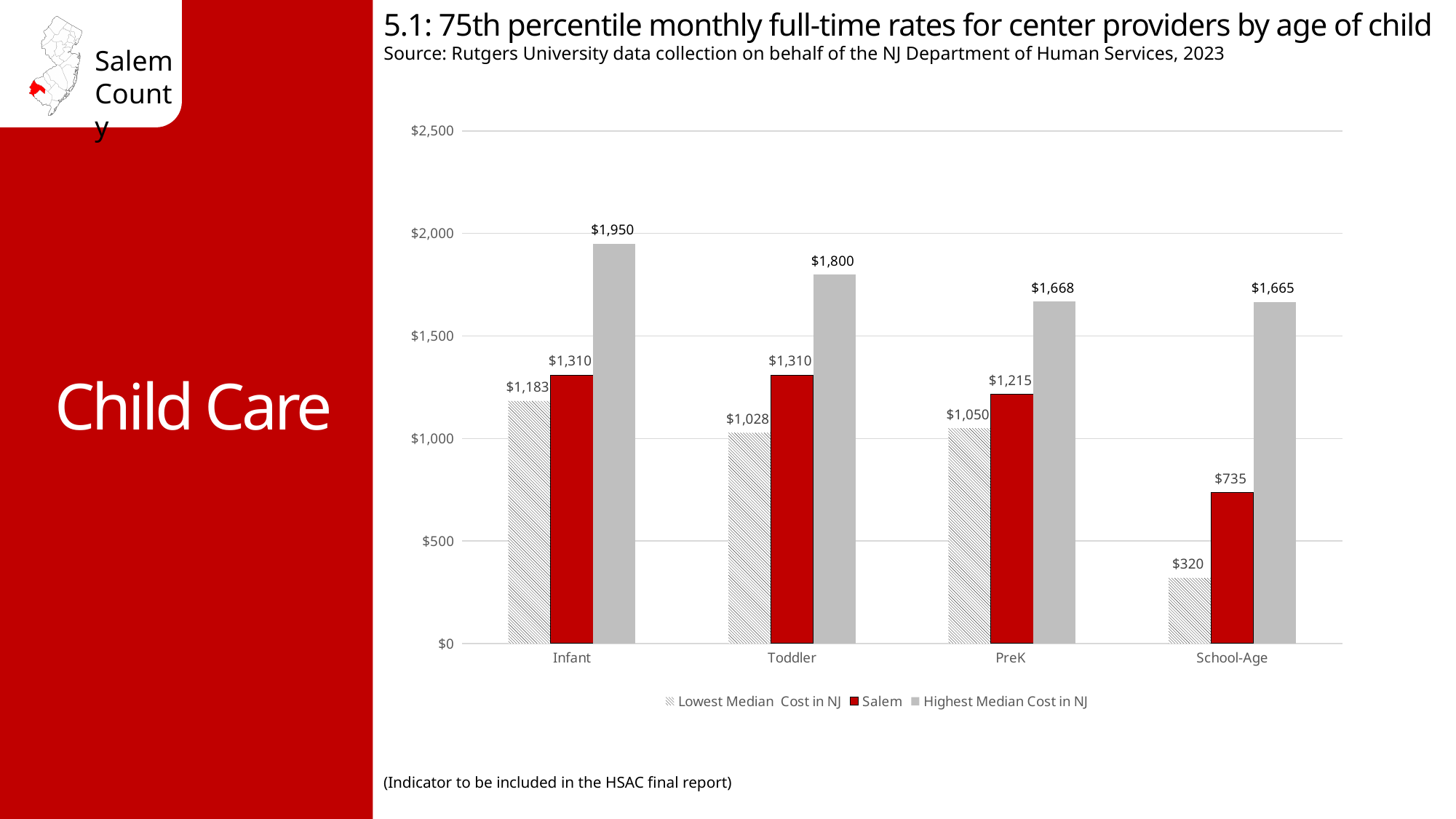
What is the difference between the Highest Median Cost in NJ and the Salem value for Infant? $640 Which age group has the lowest Highest Median Cost in NJ? School-Age How many series does the legend list? 3 Which age group has the highest Salem value? Infant and Toddler (tied at $1,310) What is the Highest Median Cost in NJ for Toddler? $1,800 What kind of chart is shown on the slide? Bar chart How many age groups are shown on the x axis? 4 What is the Salem value for Infant? $1,310 What is the Salem value for PreK? $1,215 What is the Lowest Median Cost in NJ for School-Age? $320 Which is larger for School-Age: the Salem value or the Lowest Median Cost in NJ? Salem Which series is shown in red? Salem